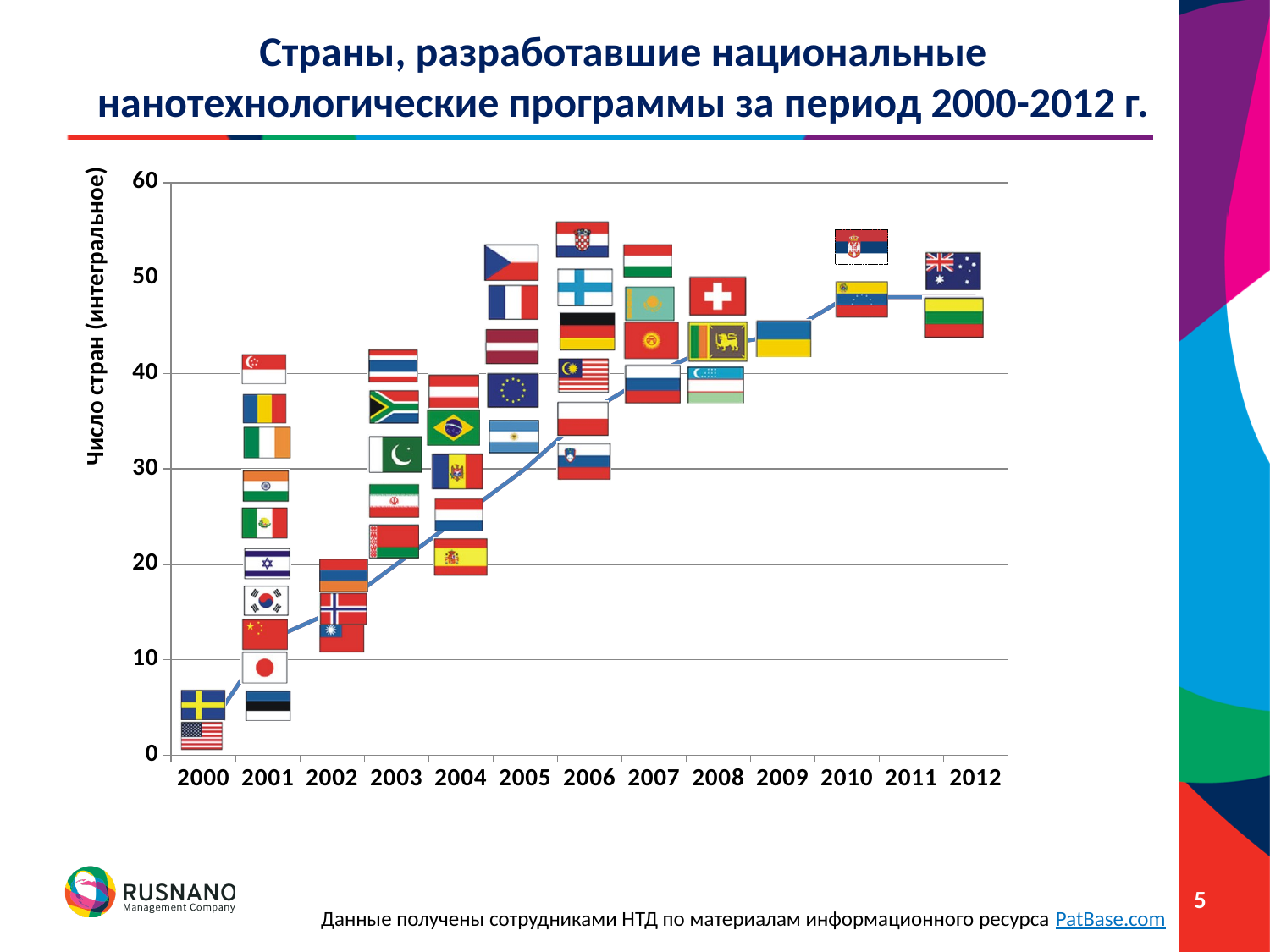
Is the value for 2001 greater or less than 10? greater Does the number of countries rise or fall from 2000 to 2012? rise Is the value for 2004 greater or less than 30? less What is the title of the chart on the slide? Страны, разработавшие национальные нанотехнологические программы за период 2000-2012 г. What kind of chart is shown on the slide? line chart Is the value for 2012 greater or less than 50? less Which year has the lowest value on the chart? 2000 How many years are shown along the x axis of the chart? 13 Which is larger, the value for 2005 or the value for 2001? 2005 What is the label of the y axis? Число стран (интегральное)